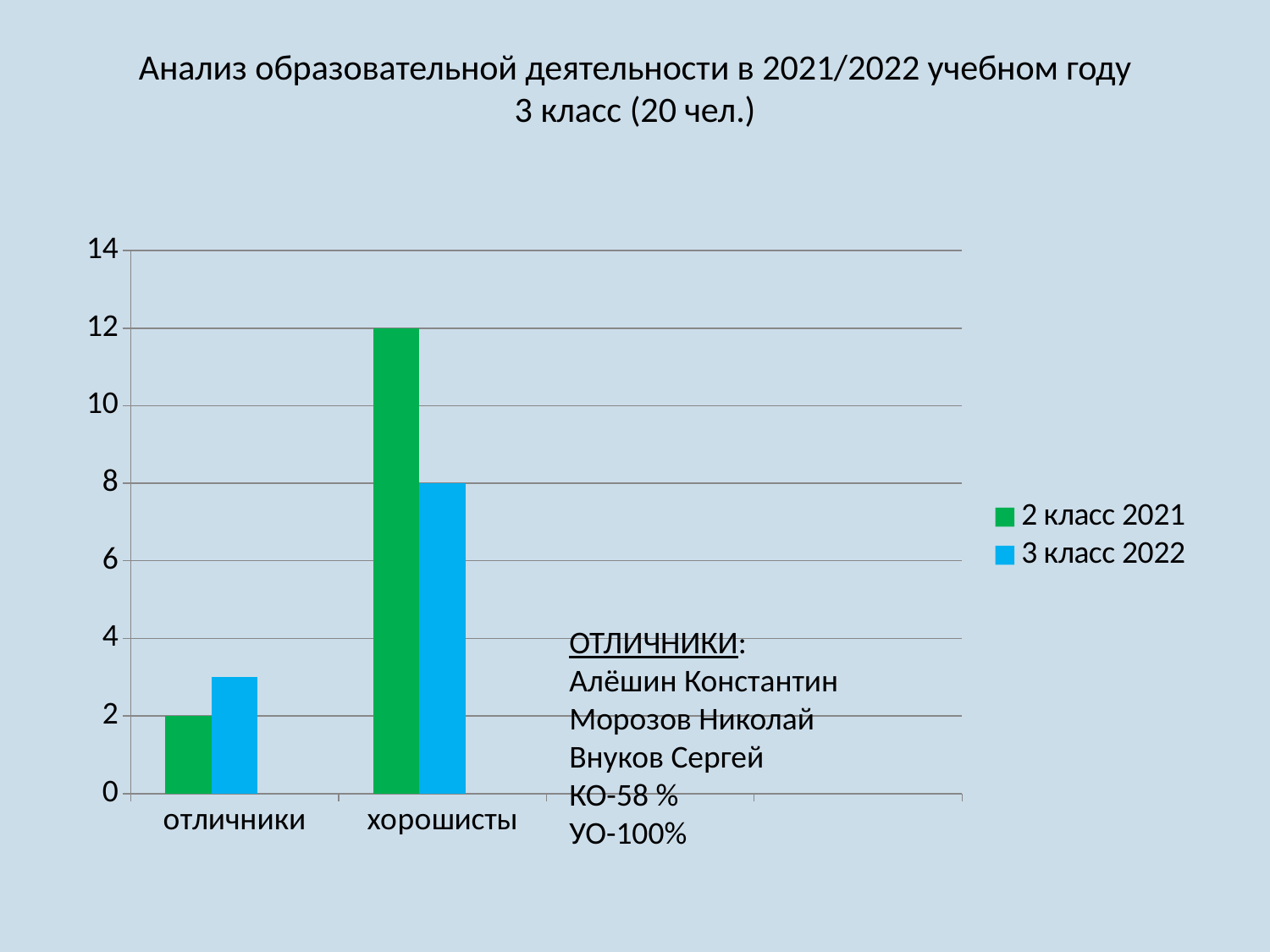
Is the value for отличники in the 3 класс 2022 series greater or less than 2? greater How many series does the legend list? 2 What is the difference between the 2 класс 2021 and 3 класс 2022 values for хорошисты? 4 What is the value for хорошисты in the 3 класс 2022 series? 8 What type of chart is shown on the slide? bar chart For хорошисты, which series has the larger value: 2 класс 2021 or 3 класс 2022? 2 класс 2021 Which category has the highest value in the 2 класс 2021 series? хорошисты Which series is shown in green in the legend? 2 класс 2021 What is the value for хорошисты in the 2 класс 2021 series? 12 How many categories are shown on the x axis? 2 What is the value for отличники in the 2 класс 2021 series? 2 Is the value for отличники in the 3 класс 2022 series greater or less than 4? less